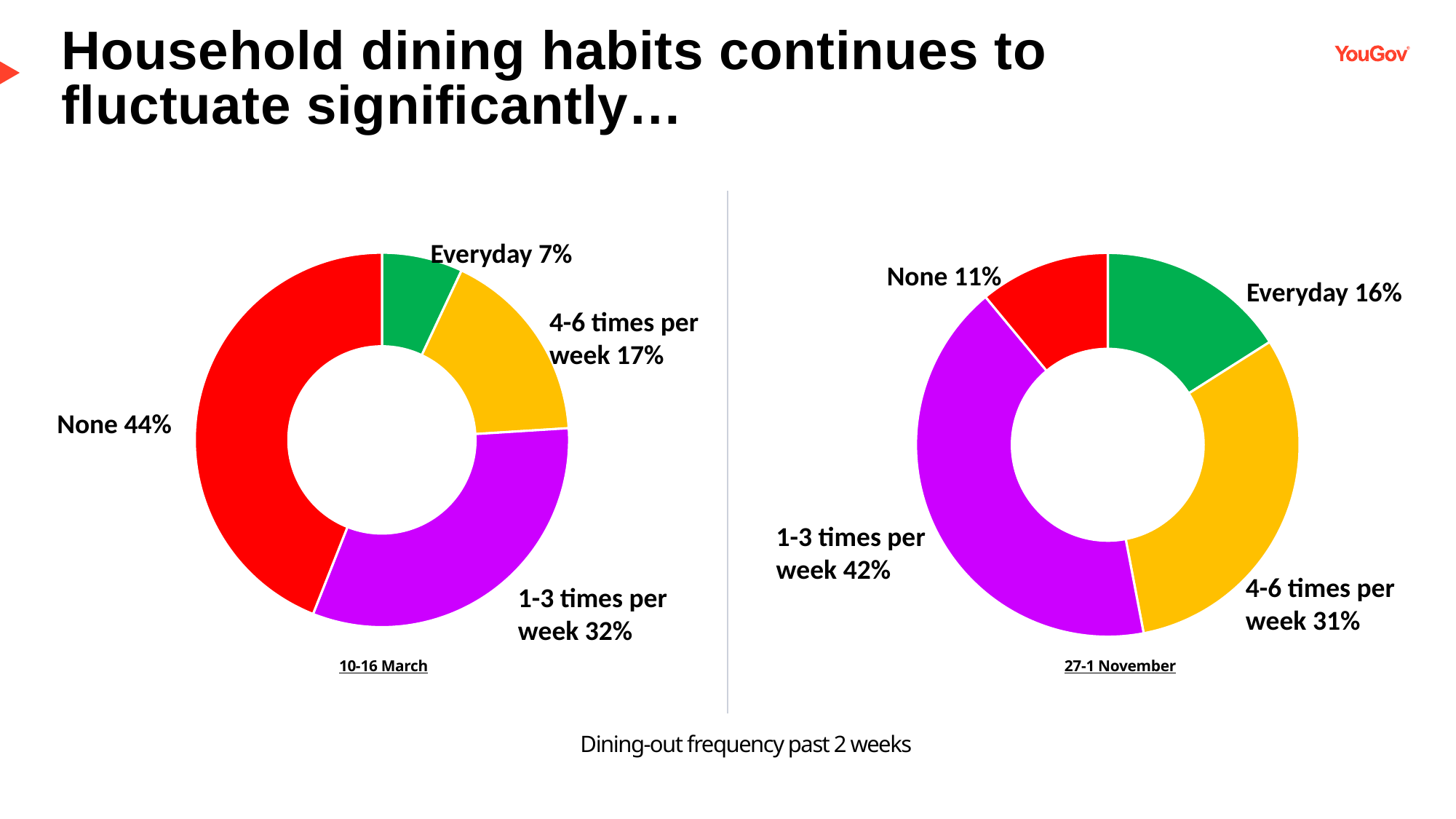
What is the difference between the 'None' share in the 10-16 March chart and the 'None' share in the 27-1 November chart? 33 percentage points In the 10-16 March chart, which category has the largest share? None In the 10-16 March chart, which category has the smallest share? Everyday In the 27-1 November chart, what share of households dined out 4-6 times per week? 31% How many categories does the 10-16 March chart show? 4 Which is larger: the 'Everyday' share in the 10-16 March chart or in the 27-1 November chart? 27-1 November In the 27-1 November chart, which category has the largest share? 1-3 times per week What kind of chart is used for the 27-1 November data? Doughnut (pie) chart What colour represents the 'None' category in both charts? Red In the 27-1 November chart, which category has the smallest share? None In the 10-16 March chart, what share of households dined out 1-3 times per week? 32% In the 27-1 November chart, what is the difference between the '1-3 times per week' and '4-6 times per week' shares? 11 percentage points